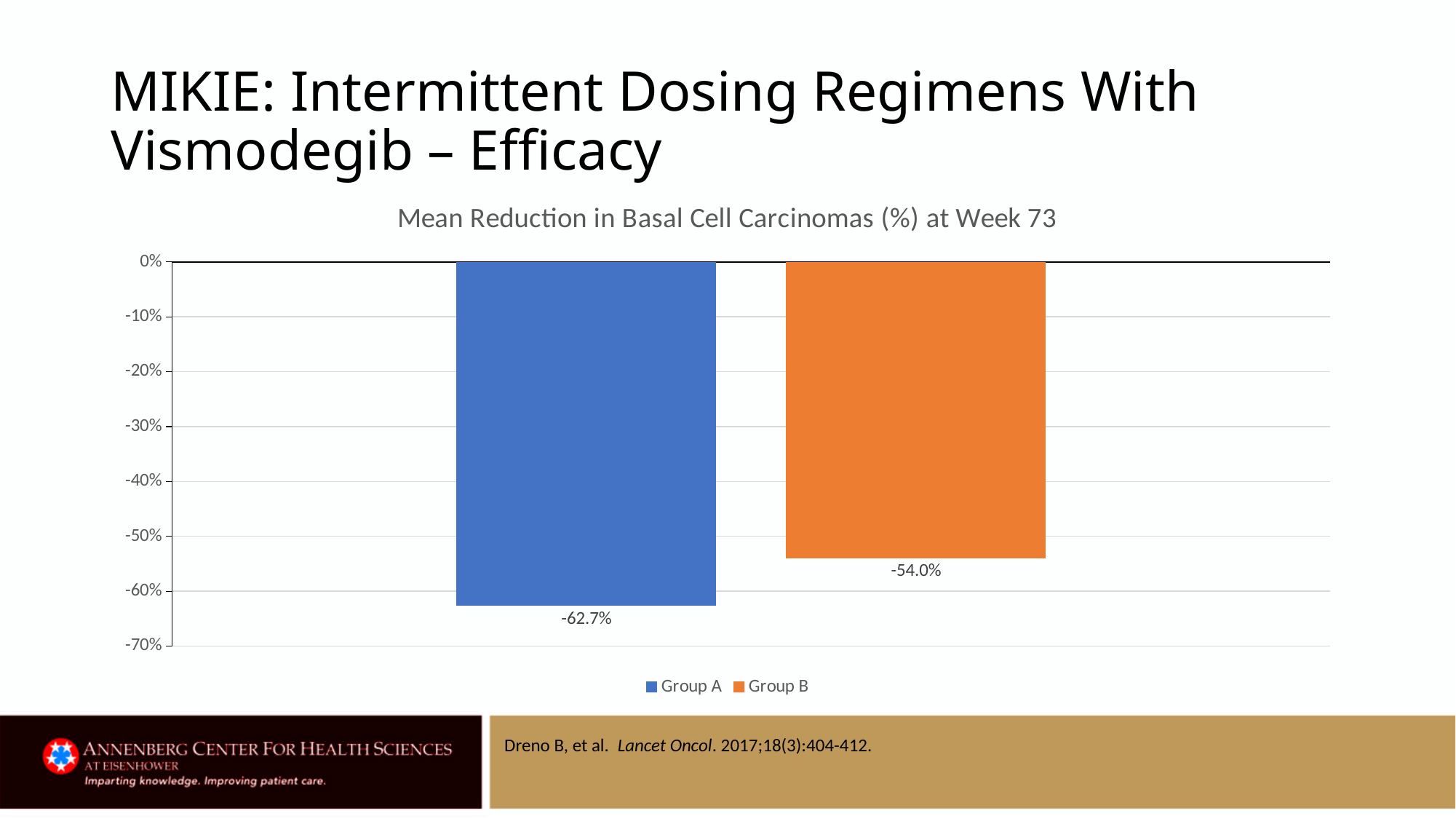
What is the title of the chart? Mean Reduction in Basal Cell Carcinomas (%) at Week 73 What colour is the bar for Group B? Orange Which group has the smallest mean reduction in basal cell carcinomas? Group B Is the value for Group B greater or less than -50%? less Which group shows the larger mean reduction in basal cell carcinomas? Group A What is the mean reduction in basal cell carcinomas at week 73 for Group A? -62.7% How many bars are plotted in the chart? 2 How many series does the legend list? 2 Is the value for Group A greater or less than -60%? less What is the difference in percentage points between the mean reductions for Group A and Group B? 8.7 percentage points What is the mean reduction in basal cell carcinomas at week 73 for Group B? -54.0% What kind of chart is shown on the slide? Bar chart